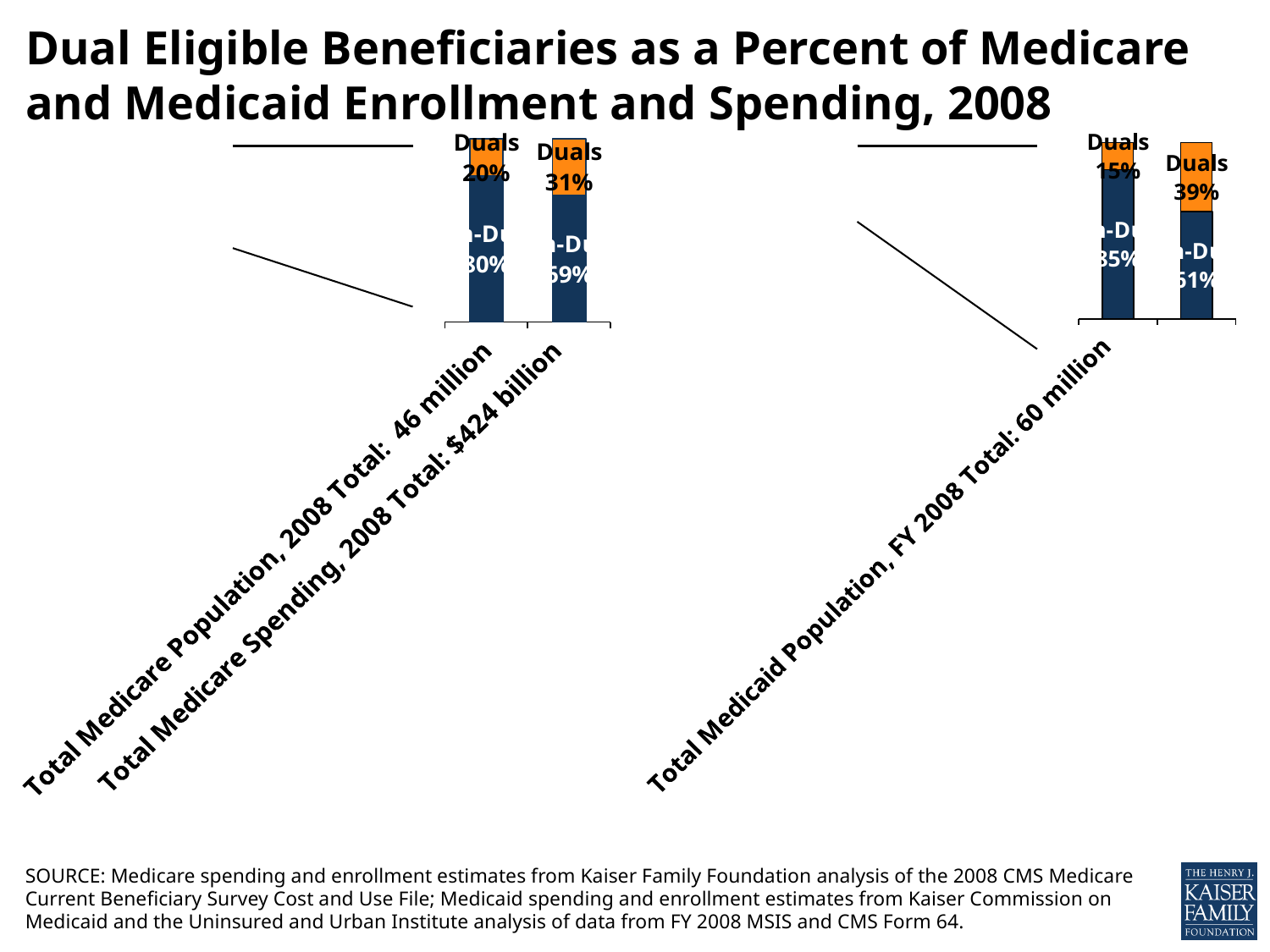
In the left chart, what percent of the Total Medicare Population, 2008 are Non-Duals? 80% In the left chart, is the Duals share larger for the Total Medicare Population, 2008 or for Total Medicare Spending, 2008? Total Medicare Spending, 2008 What kind of chart is shown on the left side of the slide? Stacked bar chart In the left chart, what percent of the Total Medicare Population, 2008 are Duals? 20% In the left chart, what percent of Total Medicare Spending, 2008 is attributed to Non-Duals? 69% How many bars does the left chart contain? 2 In the left chart, what percent of Total Medicare Spending, 2008 is attributed to Duals? 31% In the right chart, what percent of the Total Medicaid Population, FY 2008 are Duals? 15% In the left chart, what is the difference between the Duals share of Total Medicare Spending, 2008 and the Duals share of the Total Medicare Population, 2008? 11 percentage points What is the total Medicare spending for 2008 stated in the left chart's axis label? $424 billion In the left chart, what is the total of the stacked bar for Total Medicare Population, 2008? 100% In the right chart, what percent of the Total Medicaid Population, FY 2008 are Non-Duals? 85%